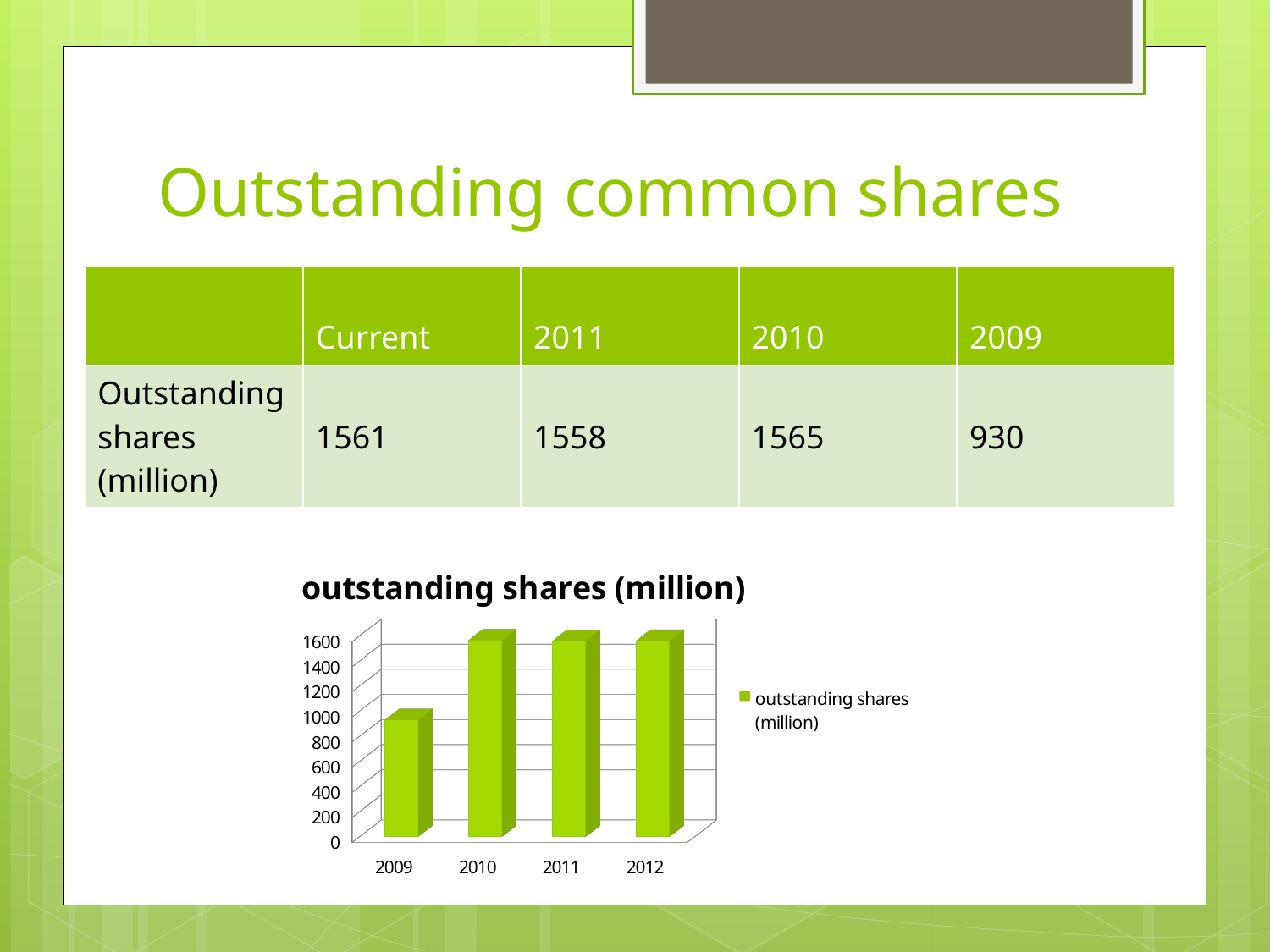
What is the title of the chart? outstanding shares (million) Which year has the lowest bar in the chart? 2009 Is the value for 2009 in the chart greater or less than 1200? less How many series does the chart legend list? 1 Does the value in the chart rise or fall from 2009 to 2010? rise Is the value for 2009 in the chart greater or less than 800? greater What kind of chart is shown on the slide? bar chart How many years are shown on the x axis of the chart? 4 Which bar is taller in the chart, 2009 or 2010? 2010 What is the legend entry of the chart? outstanding shares (million) Which bar is taller in the chart, 2009 or 2012? 2012 Is the value for 2010 in the chart greater or less than 1400? greater